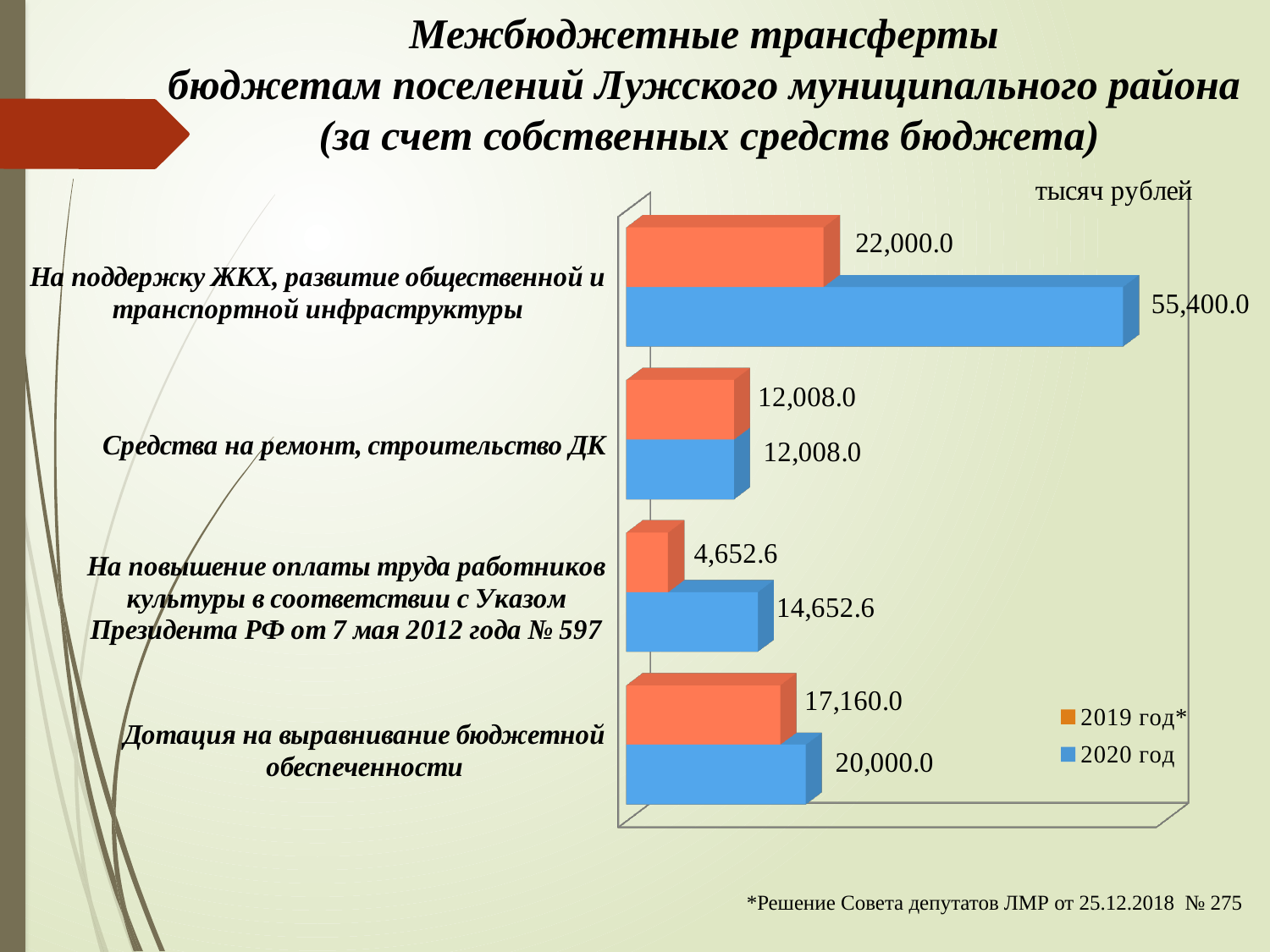
На сколько значение за 2020 год больше значения за 2019 год для категории «На поддержку ЖКХ, развитие общественной и транспортной инфраструктуры»? 33,400.0 Какое значение показано для категории «На повышение оплаты труда работников культуры в соответствии с Указом Президента РФ от 7 мая 2012 года № 597» за 2020 год? 14,652.6 Какая категория имеет наименьшее значение за 2019 год? На повышение оплаты труда работников культуры в соответствии с Указом Президента РФ от 7 мая 2012 года № 597 На сколько значение за 2020 год больше значения за 2019 год для категории «Дотация на выравнивание бюджетной обеспеченности»? 2,840.0 Какого типа эта диаграмма? Столбчатая (линейчатая) диаграмма Какое значение показано для категории «На поддержку ЖКХ, развитие общественной и транспортной инфраструктуры» за 2019 год? 22,000.0 Что больше: значение за 2019 год для категории «Дотация на выравнивание бюджетной обеспеченности» или для категории «Средства на ремонт, строительство ДК»? Дотация на выравнивание бюджетной обеспеченности Какое значение показано для категории «Дотация на выравнивание бюджетной обеспеченности» за 2020 год? 20,000.0 Что больше для категории «Средства на ремонт, строительство ДК»: значение за 2019 год или за 2020 год? Они равны (12,008.0) Сколько категорий показано на диаграмме? 4 Сколько рядов данных перечислено в легенде диаграммы? 2 Какая категория имеет наибольшее значение за 2020 год? На поддержку ЖКХ, развитие общественной и транспортной инфраструктуры